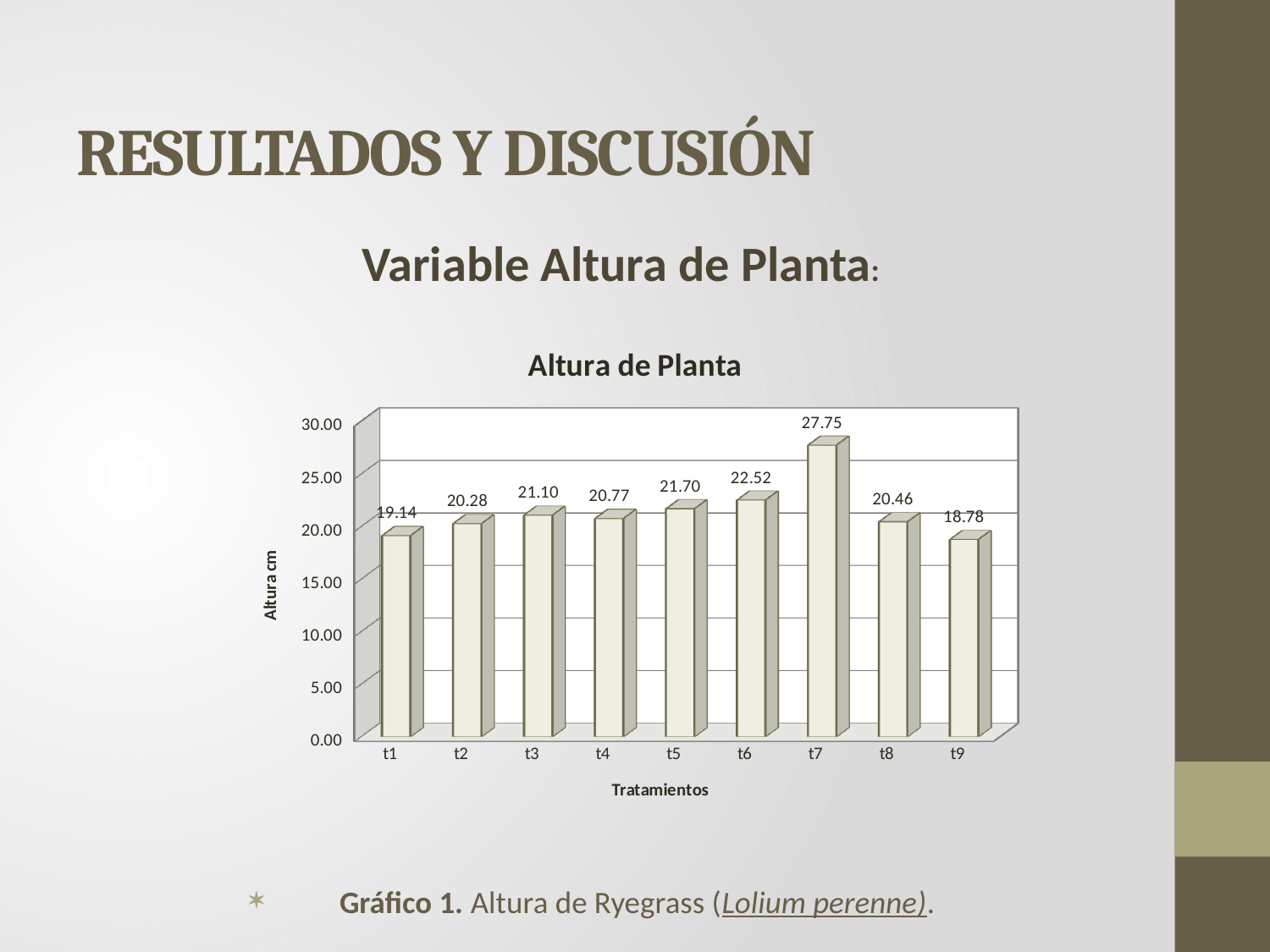
How many treatments are shown on the x axis of the Altura de Planta chart? 9 What kind of chart is the Altura de Planta chart? bar chart What is the value for t9 in the Altura de Planta chart? 18.78 What is the label of the y axis of the Altura de Planta chart? Altura cm Is the value for t7 in the Altura de Planta chart greater or less than 25.00? greater What is the difference between the values for t6 and t5 in the Altura de Planta chart? 0.82 Which treatment has the highest plant height in the Altura de Planta chart? t7 What is the difference between the values for t7 and t9 in the Altura de Planta chart? 8.97 What is the value for t7 in the Altura de Planta chart? 27.75 Which treatment has the lowest plant height in the Altura de Planta chart? t9 Which is larger in the Altura de Planta chart, the value for t3 or the value for t4? t3 What is the value for t1 in the Altura de Planta chart? 19.14